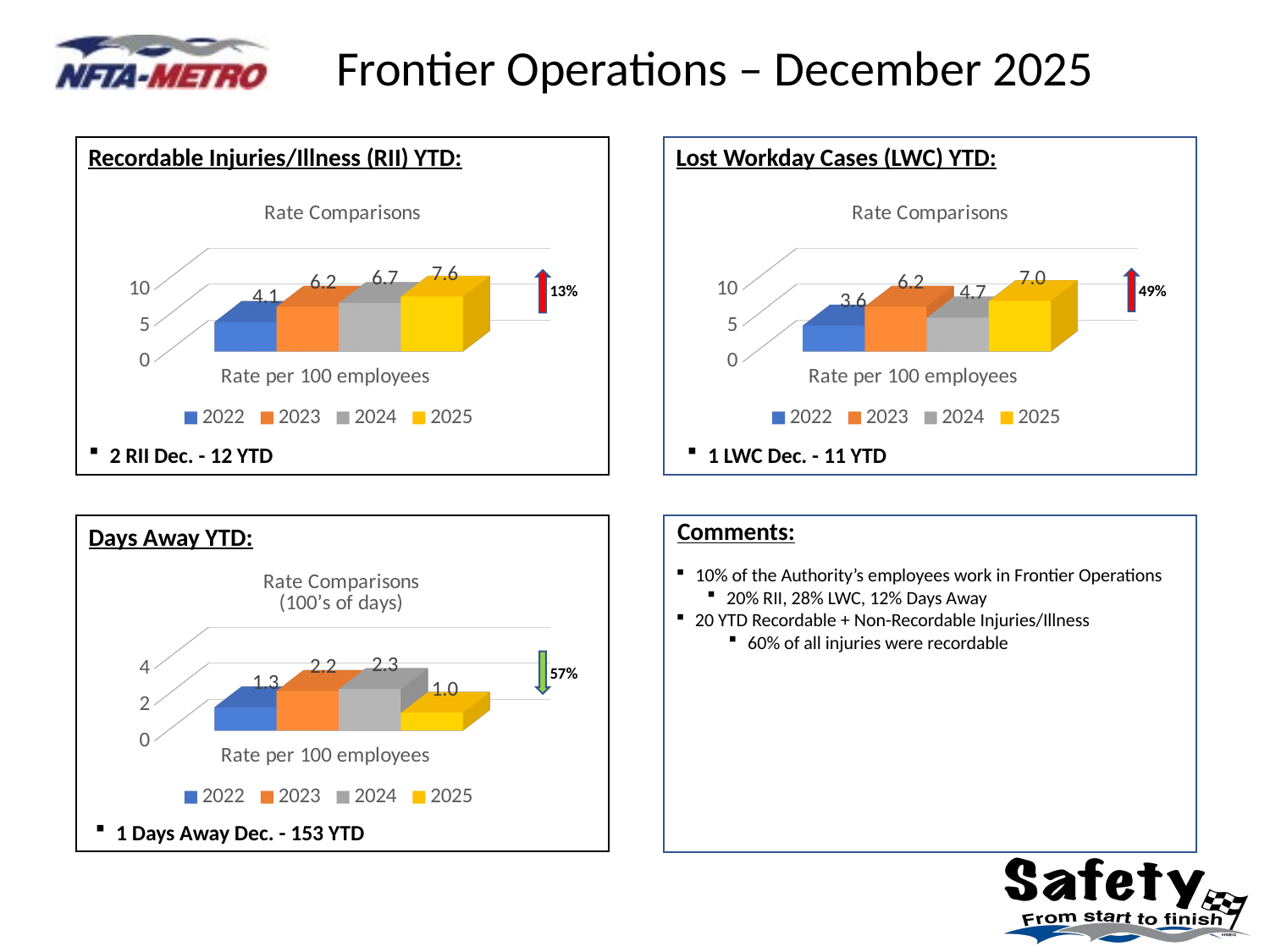
In the Recordable Injuries/Illness (RII) YTD chart, what is the difference between the 2025 and 2022 values? 3.5 How many series does the legend list in the Lost Workday Cases (LWC) YTD chart? 4 In the Recordable Injuries/Illness (RII) YTD chart, what is the value for 2025? 7.6 In the Days Away YTD chart, what is the value for 2025? 1.0 What kind of chart is the Days Away YTD chart? bar chart In the Days Away YTD chart, what is the difference between the 2024 and 2025 values? 1.3 In the Lost Workday Cases (LWC) YTD chart, which year has the highest rate? 2025 In the Lost Workday Cases (LWC) YTD chart, which is larger, the value for 2023 or the value for 2024? 2023 In the Recordable Injuries/Illness (RII) YTD chart, which year has the lowest rate? 2022 In the Days Away YTD chart, which year has the highest value? 2024 In the Lost Workday Cases (LWC) YTD chart, what is the value for 2024? 4.7 In the Recordable Injuries/Illness (RII) YTD chart, do the values rise or fall from 2022 to 2025? rise